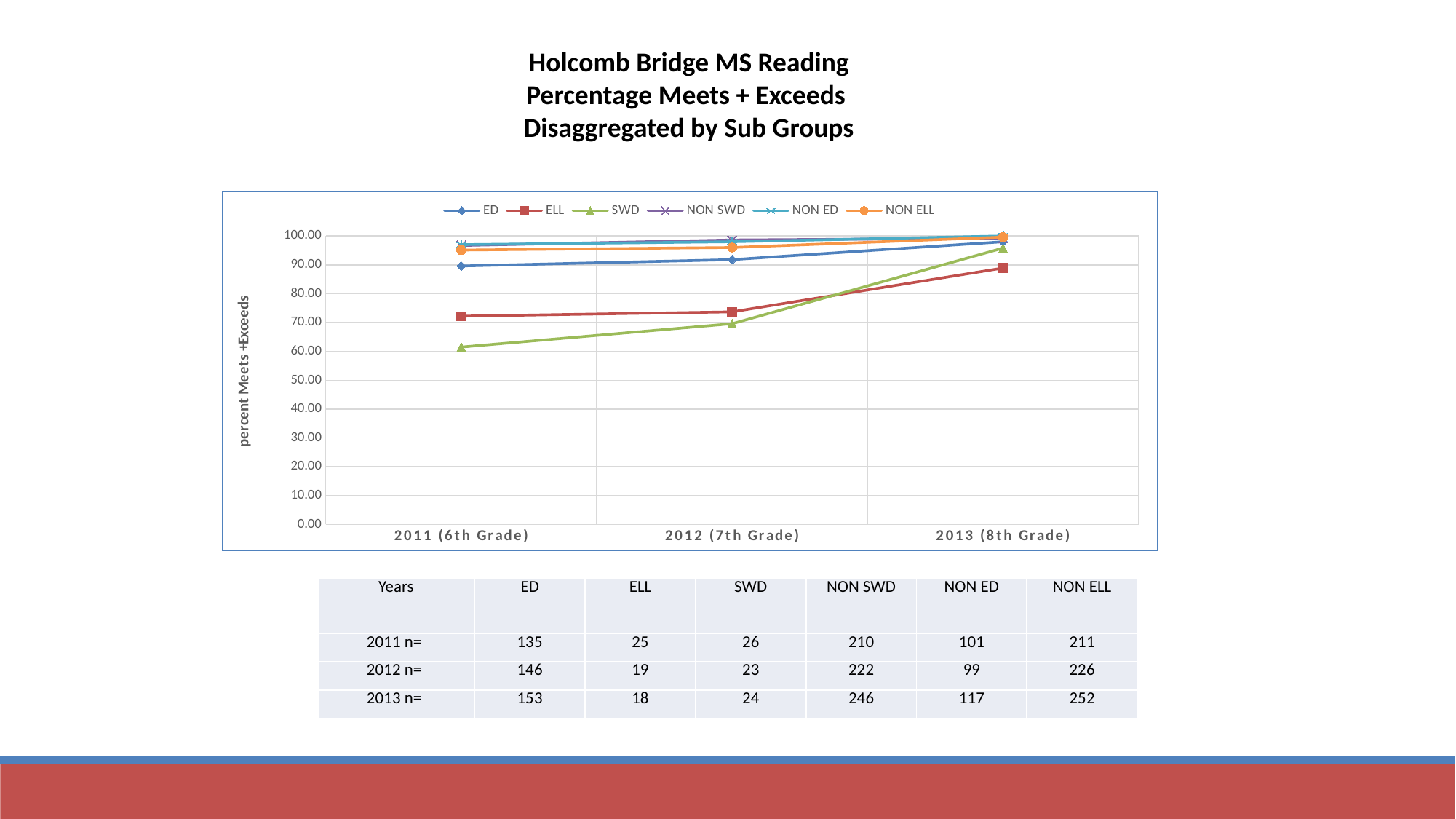
What kind of chart is shown on the slide? line chart Is the value for SWD in 2011 (6th Grade) greater or less than 70.00? less Is the value for ED in 2011 (6th Grade) greater or less than 80.00? greater Which sub group has the lowest value in 2011 (6th Grade)? SWD Which sub group has the lowest value in 2013 (8th Grade)? ELL Is the value for ELL in 2013 (8th Grade) greater or less than 80.00? greater What is the label on the chart's vertical axis? percent Meets +Exceeds Does the SWD line rise or fall from 2011 (6th Grade) to 2013 (8th Grade)? rise How many series does the chart's legend list? 6 How many categories are shown along the x axis of the chart? 3 In 2013 (8th Grade), which is larger: the value for SWD or the value for ELL? SWD